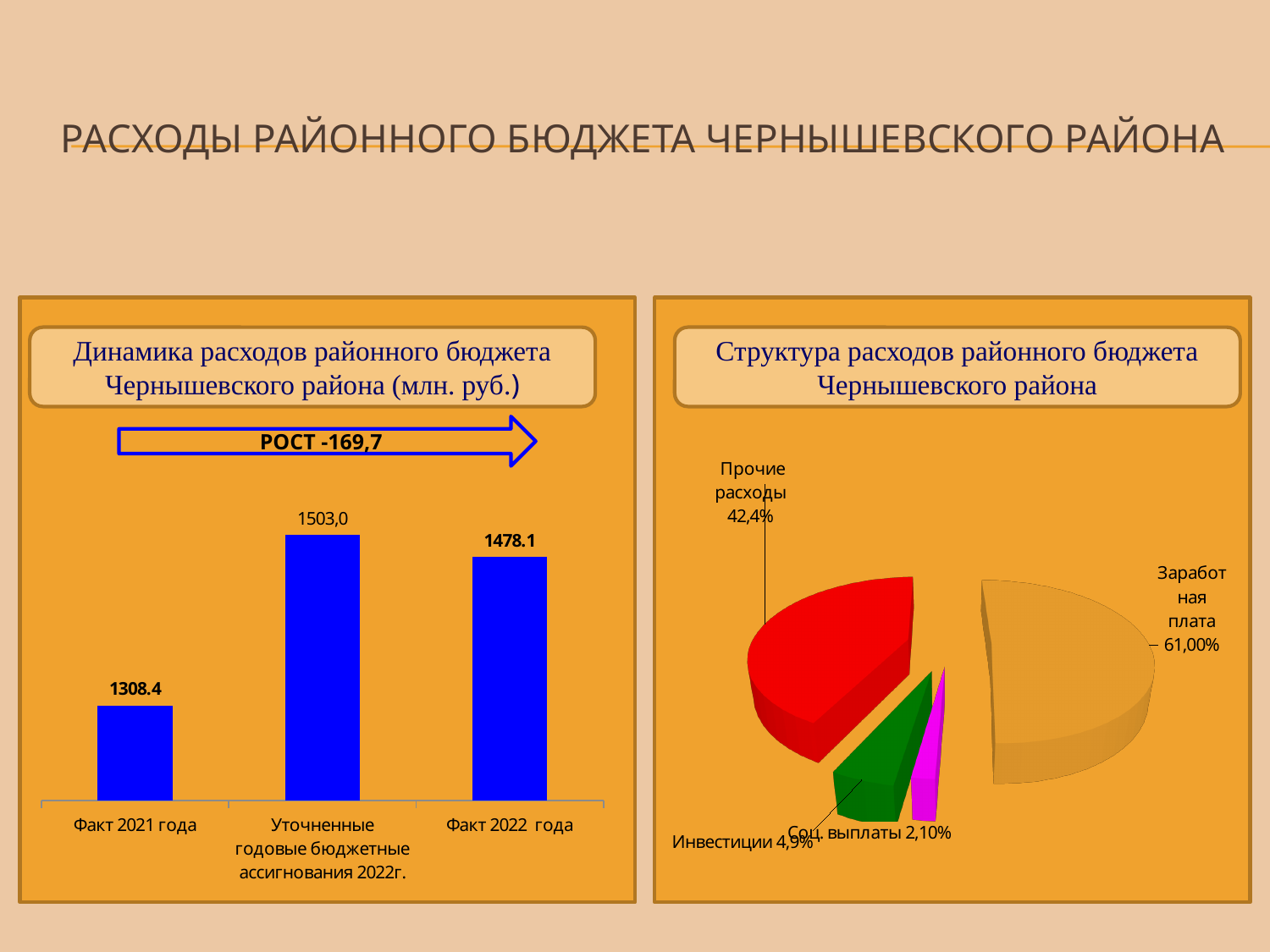
In the bar chart on the left, what is the value for 'Уточненные годовые бюджетные ассигнования 2022г.'? 1503,0 In the pie chart 'Структура расходов районного бюджета Чернышевского района', what share is 'Заработная плата'? 61,00% In the bar chart on the left, what is the difference between 'Факт 2022 года' and 'Факт 2021 года'? 169.7 In the bar chart on the left, which category has the lowest value? Факт 2021 года What kind of chart is shown on the left side of the slide? Bar chart In the pie chart on the right, how many slices are there? 4 In the bar chart 'Динамика расходов районного бюджета Чернышевского района (млн. руб.)', what is the value for 'Факт 2021 года'? 1308.4 In the bar chart on the left, which category has the highest value? Уточненные годовые бюджетные ассигнования 2022г. In the pie chart on the right, which slice is the smallest? Соц. выплаты In the bar chart on the left, what is the value for 'Факт 2022 года'? 1478.1 In the pie chart on the right, what share is 'Прочие расходы'? 42,4% In the bar chart on the left, how many bars are plotted? 3